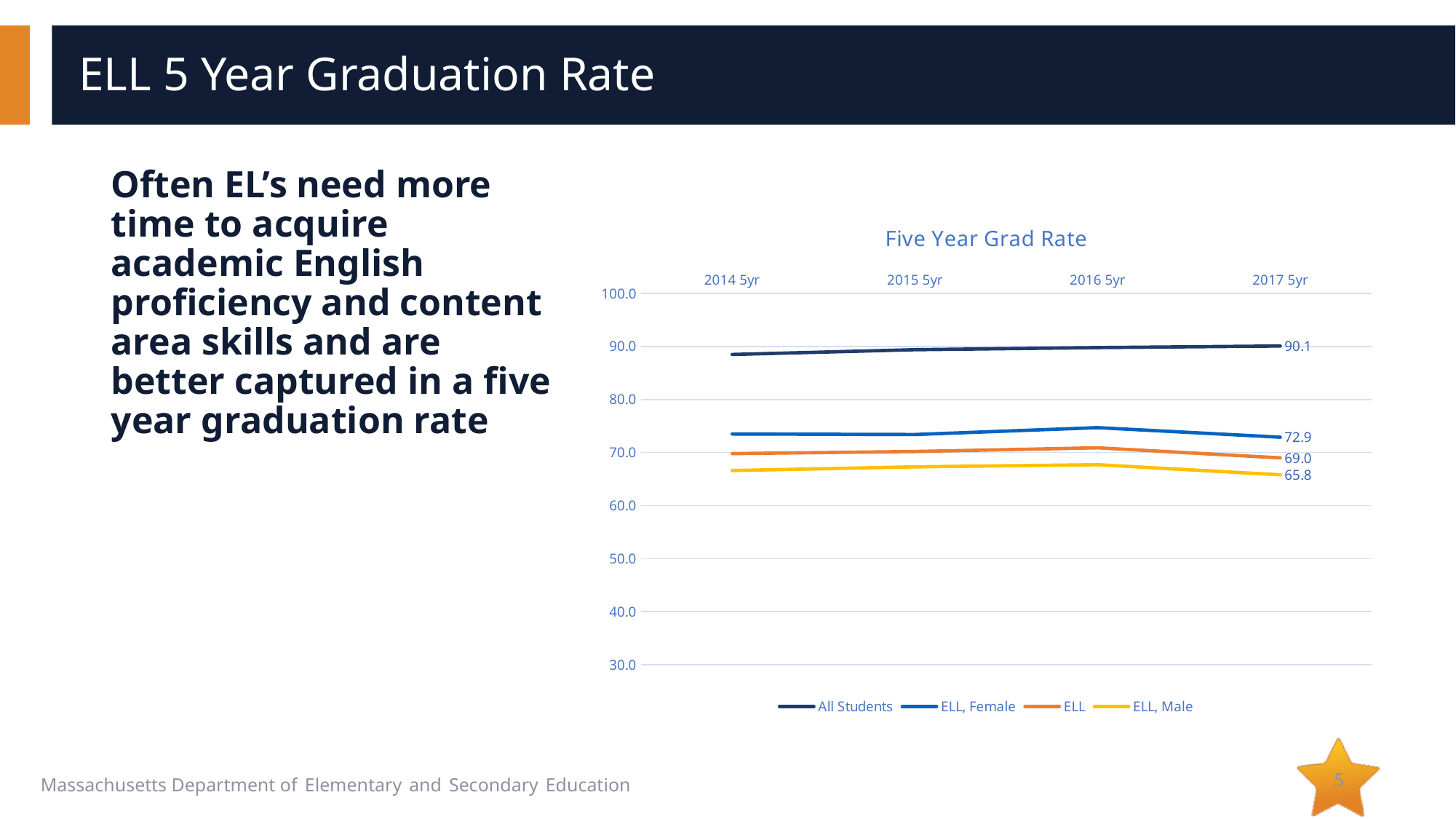
How many series does the legend list? 4 What kind of chart is shown on the slide? Line chart What is the value for ELL, Female in 2017 5yr? 72.9 What is the difference between the All Students and ELL values in 2017 5yr? 21.1 What is the value for ELL in 2017 5yr? 69.0 What is the value for All Students in 2017 5yr? 90.1 What is the title of the chart? Five Year Grad Rate Is the value for All Students in 2014 5yr greater or less than 80.0? greater Which series has the highest value in 2017 5yr? All Students What is the value for ELL, Male in 2017 5yr? 65.8 Which is larger in 2017 5yr, ELL, Female or ELL, Male? ELL, Female Which series has the lowest value in 2017 5yr? ELL, Male